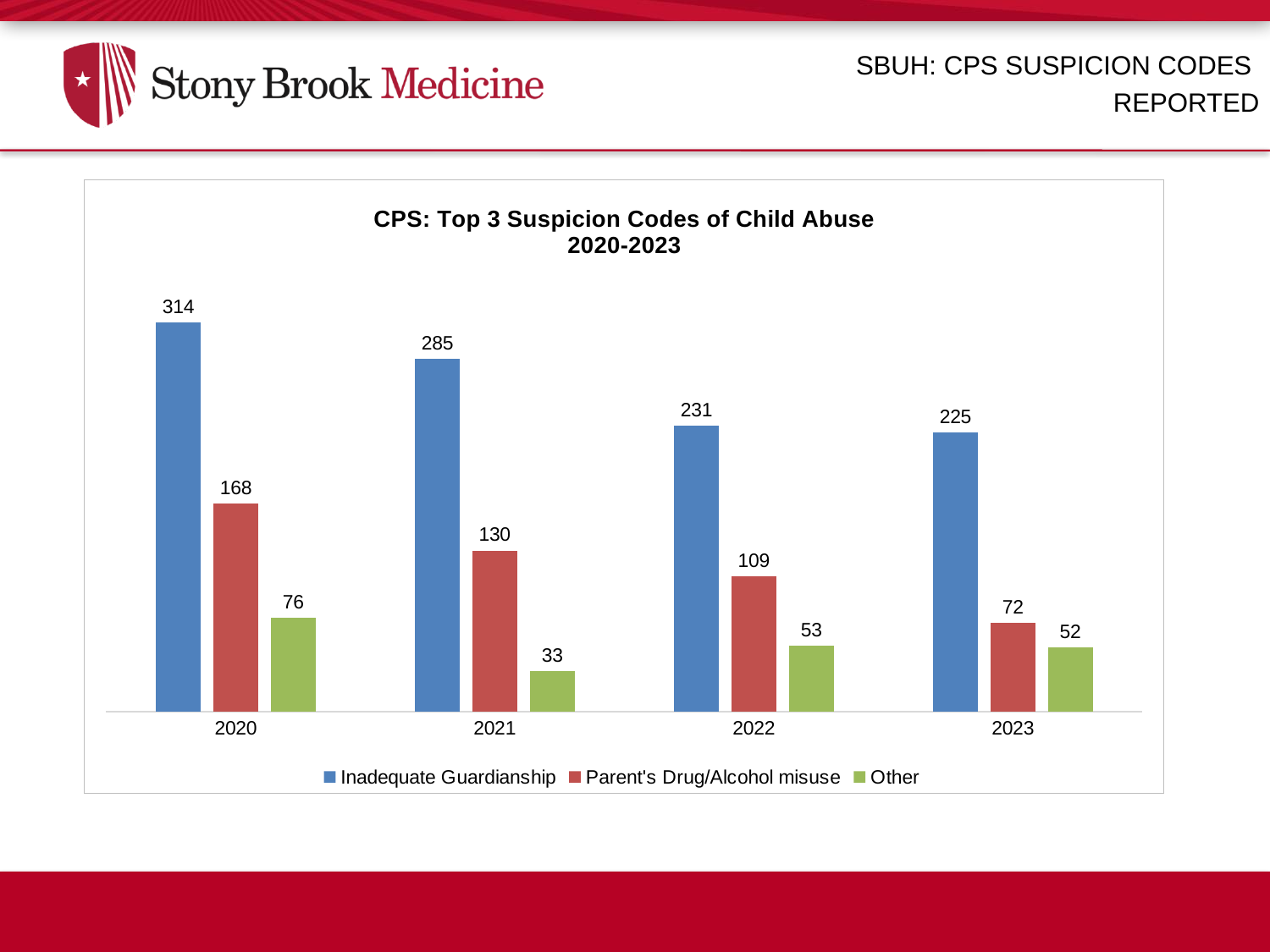
In which year is the Inadequate Guardianship value highest? 2020 What is the value for Other in 2021? 33 How many years are shown on the x axis? 4 What is the value for Inadequate Guardianship in 2020? 314 How many series does the legend list? 3 What is the difference between the Inadequate Guardianship values for 2020 and 2023? 89 What is the value for Parent's Drug/Alcohol misuse in 2022? 109 Does the Inadequate Guardianship value rise or fall from 2020 to 2023? Fall What kind of chart is shown? Bar chart What is the title of the chart? CPS: Top 3 Suspicion Codes of Child Abuse 2020-2023 In which year is the Other value lowest? 2021 Which is larger: Parent's Drug/Alcohol misuse in 2021 or Other in 2020? Parent's Drug/Alcohol misuse in 2021